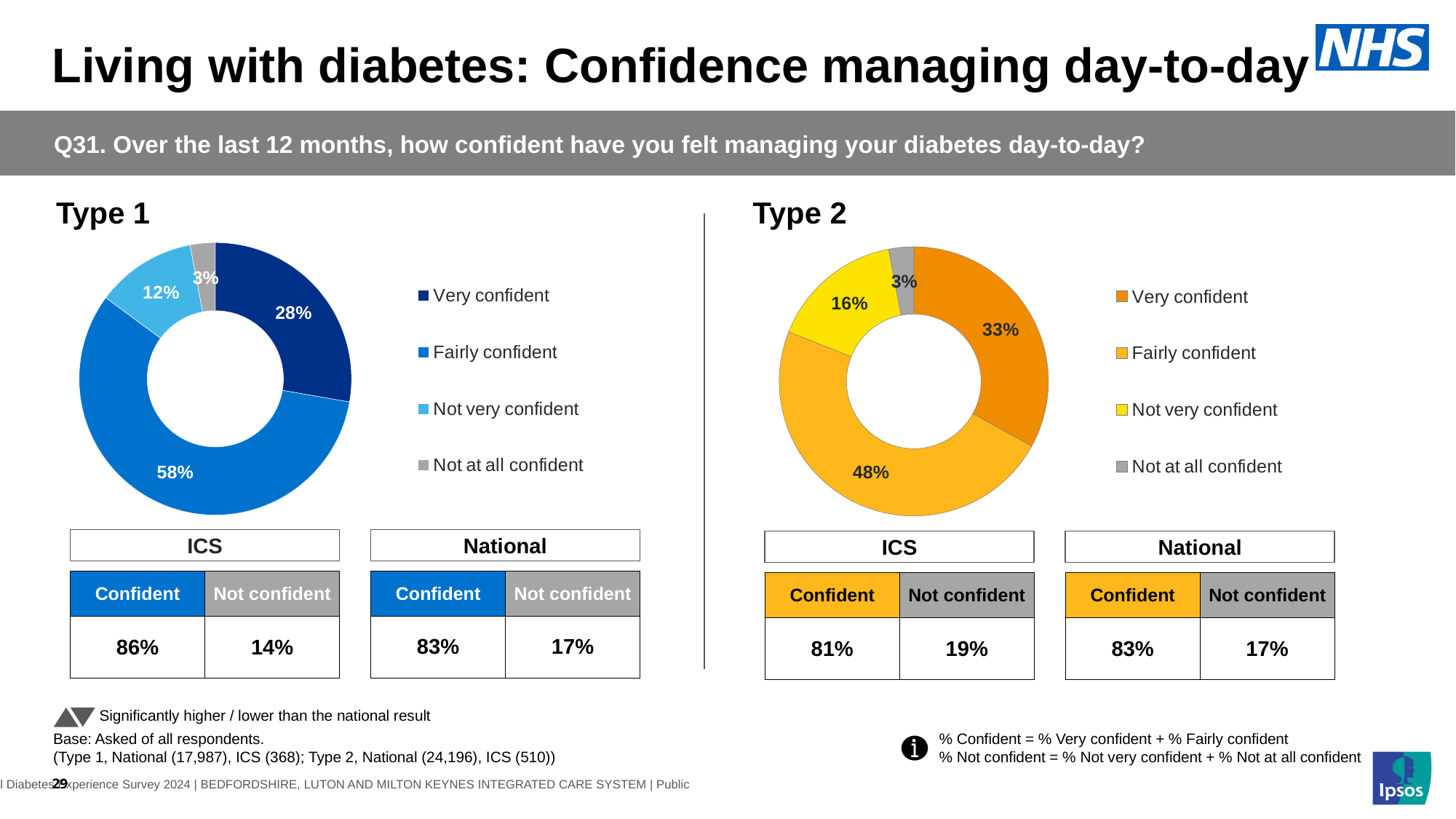
In the Type 1 chart, what is the difference between the Fairly confident and Very confident shares? 30 percentage points In the Type 1 chart, which category has the smallest share? Not at all confident In the Type 2 chart, what is the difference between the Fairly confident and Not very confident shares? 32 percentage points How many categories does the Type 1 chart show? 4 In the Type 2 chart, which category has the largest share? Fairly confident In the Type 2 chart, what percentage of respondents were Very confident? 33% In the Type 1 chart, what colour represents Very confident? Dark blue In the Type 2 chart, what percentage of respondents were Not at all confident? 3% What kind of chart is used for Type 2? Donut (pie) chart In the Type 1 chart, what percentage of respondents were Fairly confident? 58% In the Type 1 chart, what percentage of respondents were Not very confident? 12% Which chart shows a larger share for Very confident, Type 1 or Type 2? Type 2